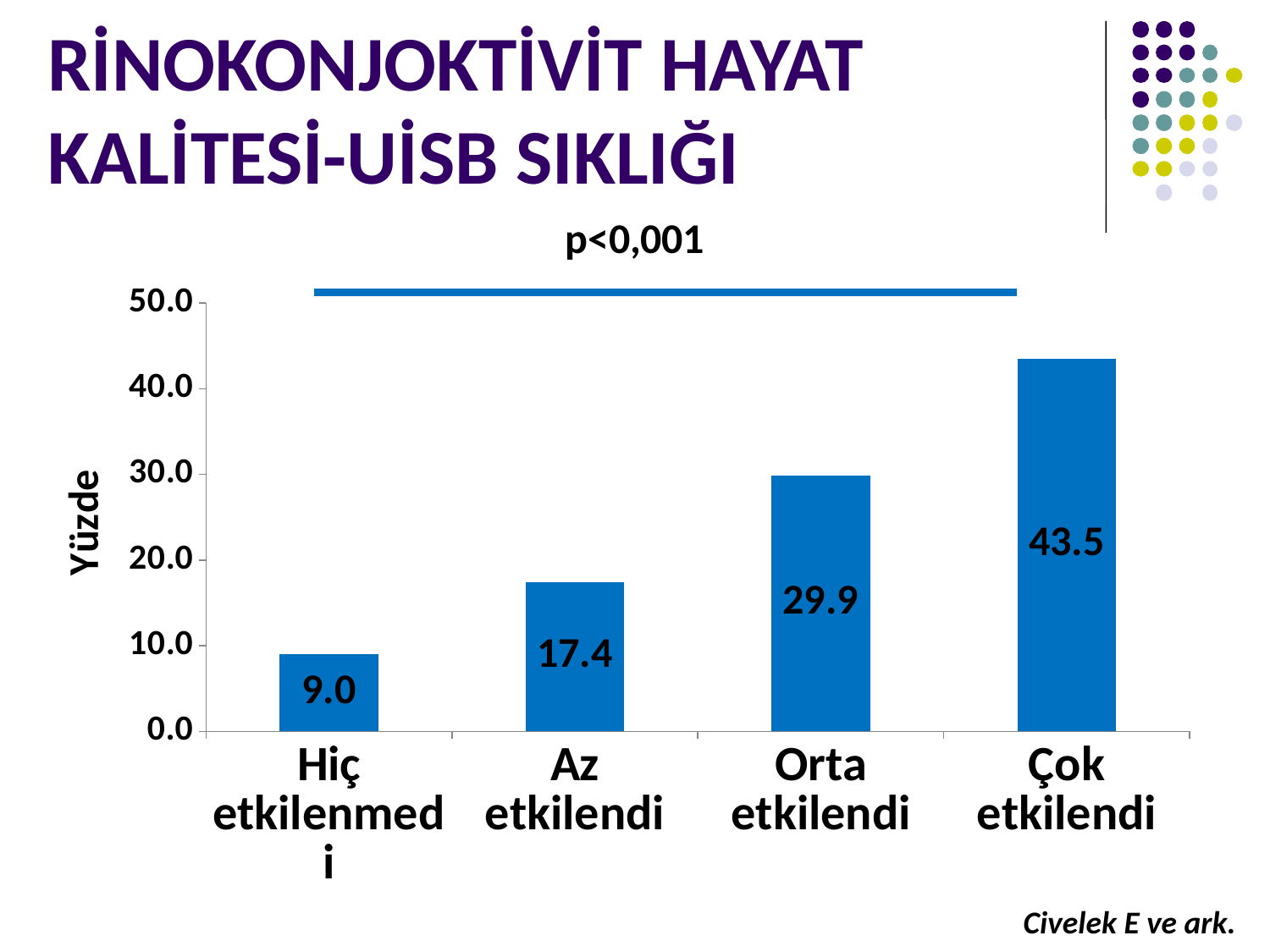
How many categories are shown on the x axis? 4 What is the value for "Çok etkilendi"? 43.5 Is the value for "Çok etkilendi" greater or less than 40.0? greater Do the values rise or fall from left to right along the x axis? rise What kind of chart is shown on the slide? bar chart What is the value for "Az etkilendi"? 17.4 What is the value for "Orta etkilendi"? 29.9 What is the difference between the values for "Çok etkilendi" and "Orta etkilendi"? 13.6 Which category has the lowest value? Hiç etkilenmedi Which category has the highest value? Çok etkilendi What is the value for "Hiç etkilenmedi"? 9.0 Which is larger, the value for "Az etkilendi" or the value for "Orta etkilendi"? Orta etkilendi